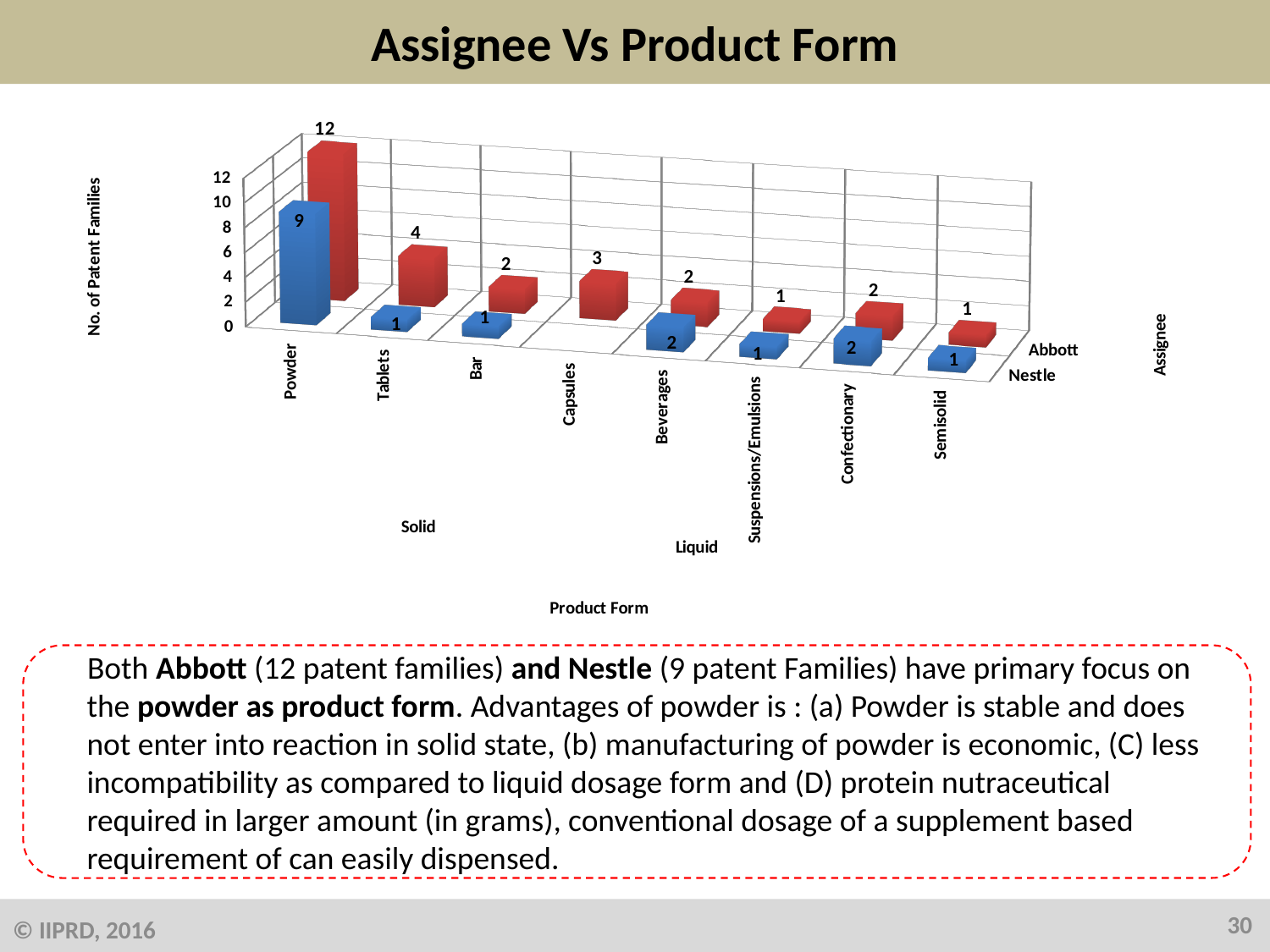
Which product form has the highest number of patent families for Abbott? Powder What is the number of patent families for Abbott in the Capsules product form? 3 What is the number of patent families for Nestle in the Powder product form? 9 How many product form categories are shown on the x axis of the chart? 8 What is the difference between Abbott's and Nestle's number of patent families for Powder? 3 What is the number of patent families for Nestle in the Beverages product form? 2 What is the number of patent families for Abbott in the Powder product form? 12 What type of chart is shown on the slide? Bar chart Which assignee has more patent families in the Tablets product form, Abbott or Nestle? Abbott How many assignee series are shown in the chart? 2 Which product form has the highest number of patent families for Nestle? Powder What is the number of patent families for Abbott in the Tablets product form? 4